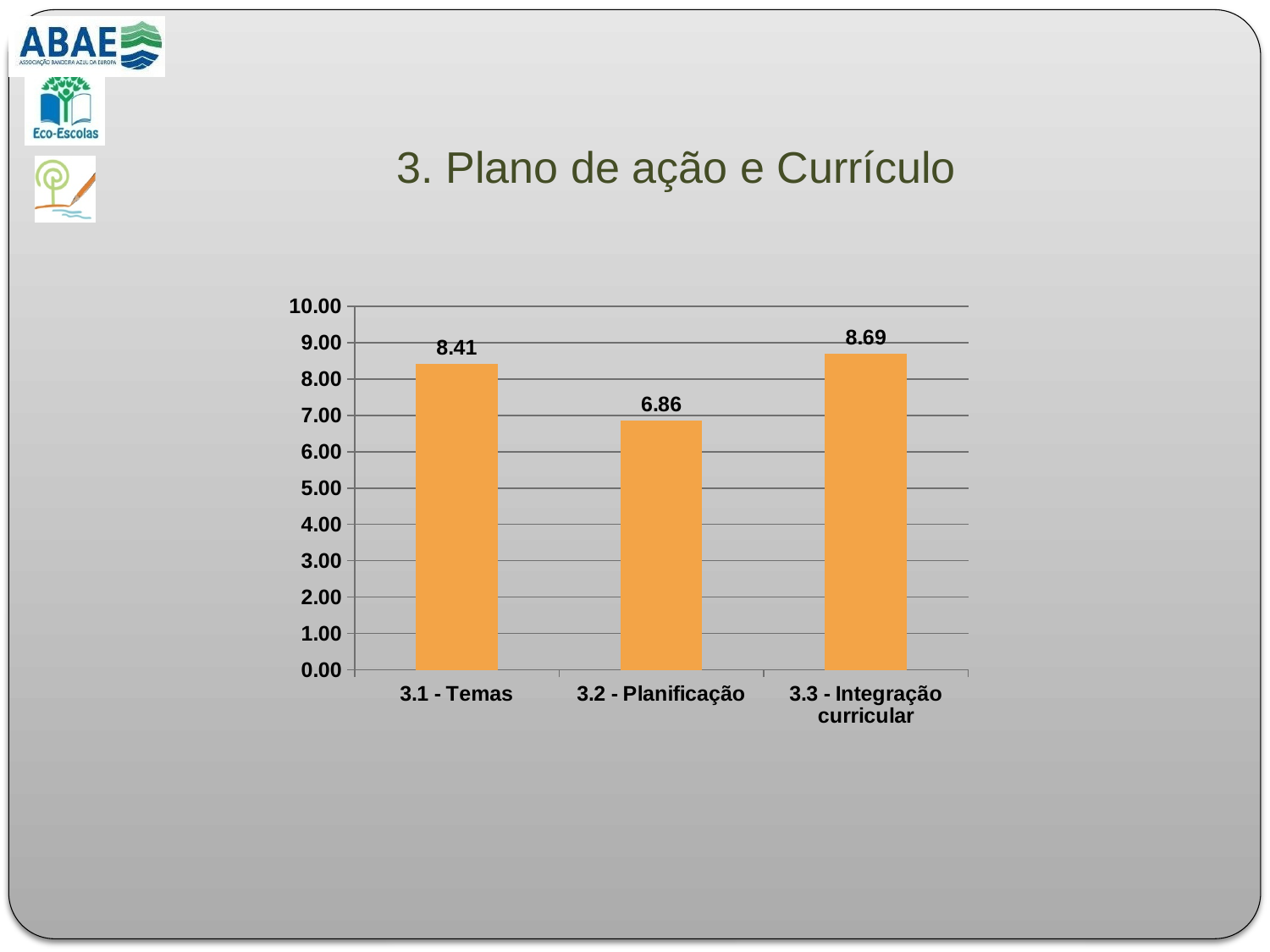
Which category has the highest value? 3.3 - Integração curricular Which is larger, the value for 3.1 - Temas or the value for 3.2 - Planificação? 3.1 - Temas How many categories are shown on the chart? 3 What is the title of the slide containing the chart? 3. Plano de ação e Currículo Is the value for 3.2 - Planificação greater or less than 7.00? less What is the value for 3.1 - Temas? 8.41 What is the value for 3.3 - Integração curricular? 8.69 What is the value for 3.2 - Planificação? 6.86 What is the difference between the values for 3.3 - Integração curricular and 3.1 - Temas? 0.28 What kind of chart is shown on the slide? bar chart What is the difference between the values for 3.3 - Integração curricular and 3.2 - Planificação? 1.83 Which category has the lowest value? 3.2 - Planificação